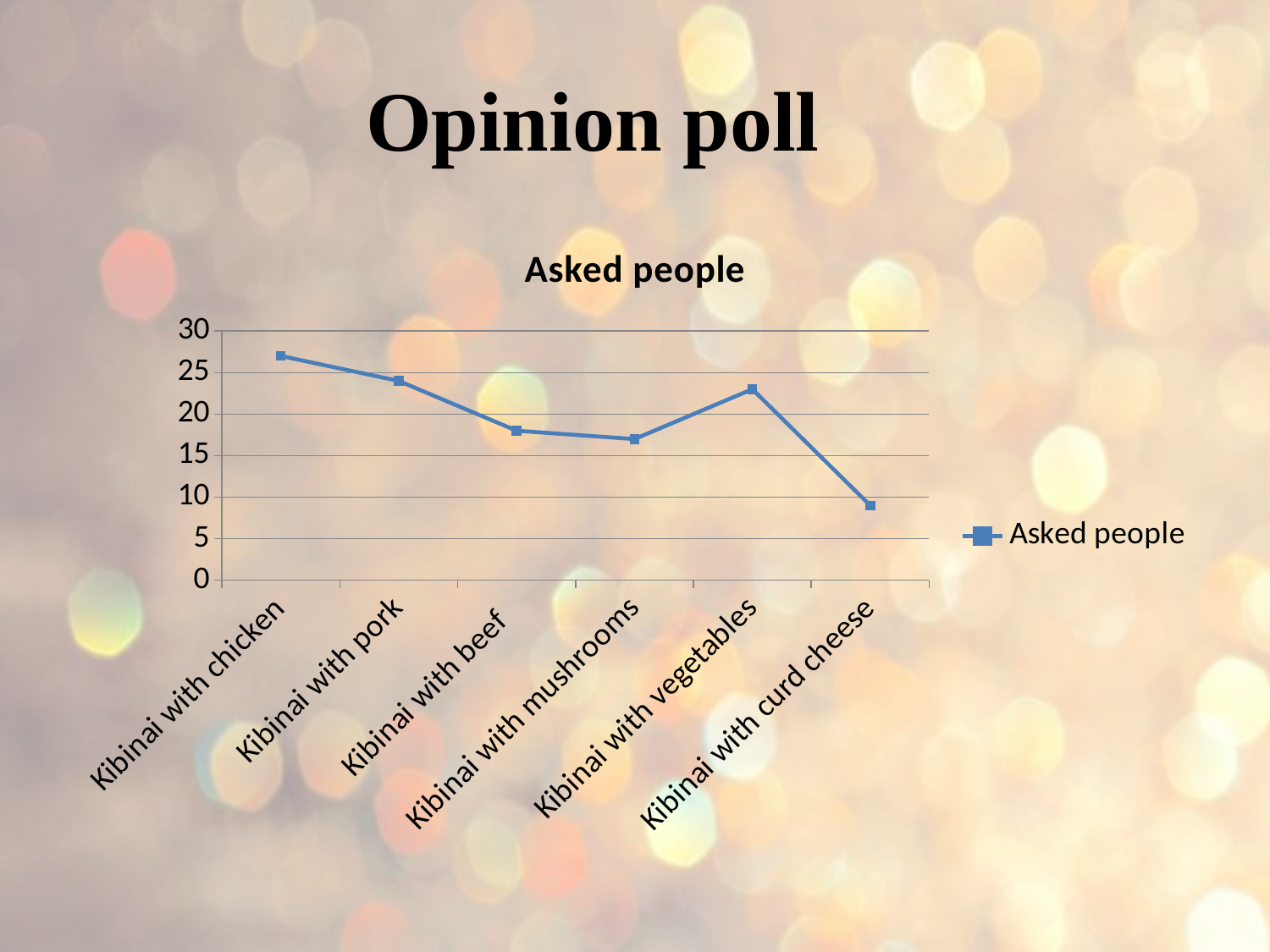
Which is larger, the value for Kibinai with chicken or the value for Kibinai with pork? Kibinai with chicken How many series does the legend list? 1 Is the value for Kibinai with chicken greater or less than 25? greater What is the title of the chart? Asked people Is the value for Kibinai with curd cheese greater or less than 10? less Which is larger, the value for Kibinai with beef or the value for Kibinai with vegetables? Kibinai with vegetables Which category has the lowest value in the chart? Kibinai with curd cheese What kind of chart is shown on the slide? line chart Which category has the highest value in the chart? Kibinai with chicken How many categories are plotted on the x axis of the chart? 6 Is the value for Kibinai with beef greater or less than 20? less